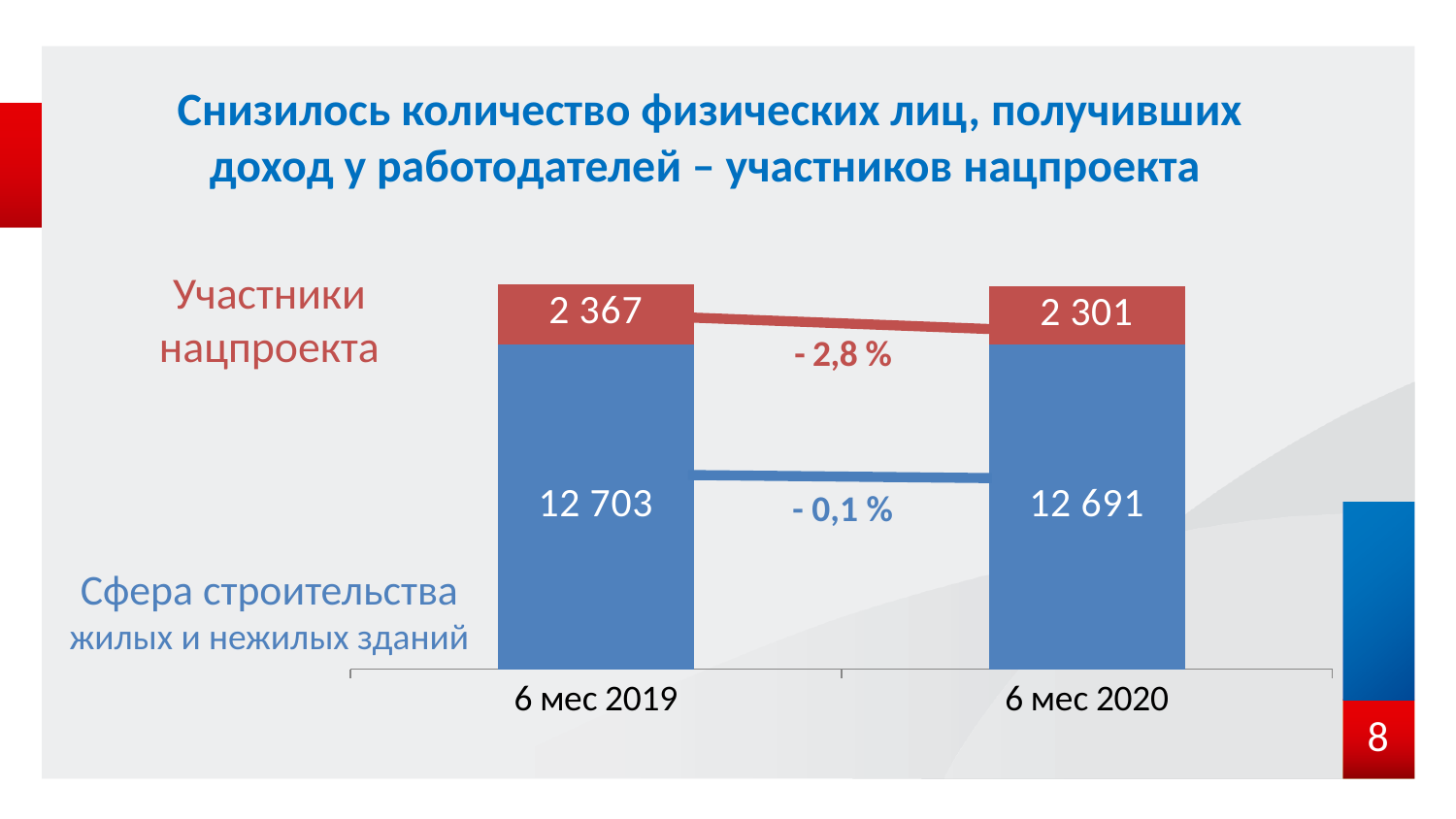
What is the value for Участники нацпроекта in 6 мес 2020? 2 301 What percentage change is shown for Сфера строительства жилых и нежилых зданий between 6 мес 2019 and 6 мес 2020? - 0,1 % What percentage change is shown for Участники нацпроекта between 6 мес 2019 and 6 мес 2020? - 2,8 % What is the value for Сфера строительства жилых и нежилых зданий in 6 мес 2019? 12 703 What is the value for Участники нацпроекта in 6 мес 2019? 2 367 What type of chart is shown on the slide? Stacked bar chart What is the total of the stacked bar for 6 мес 2020? 14 992 What is the total of the stacked bar for 6 мес 2019? 15 070 How many data series are shown in the chart? 2 What is the value for Сфера строительства жилых и нежилых зданий in 6 мес 2020? 12 691 By how much did the value for Участники нацпроекта decrease from 6 мес 2019 to 6 мес 2020? 66 By how much did the value for Сфера строительства жилых и нежилых зданий decrease from 6 мес 2019 to 6 мес 2020? 12